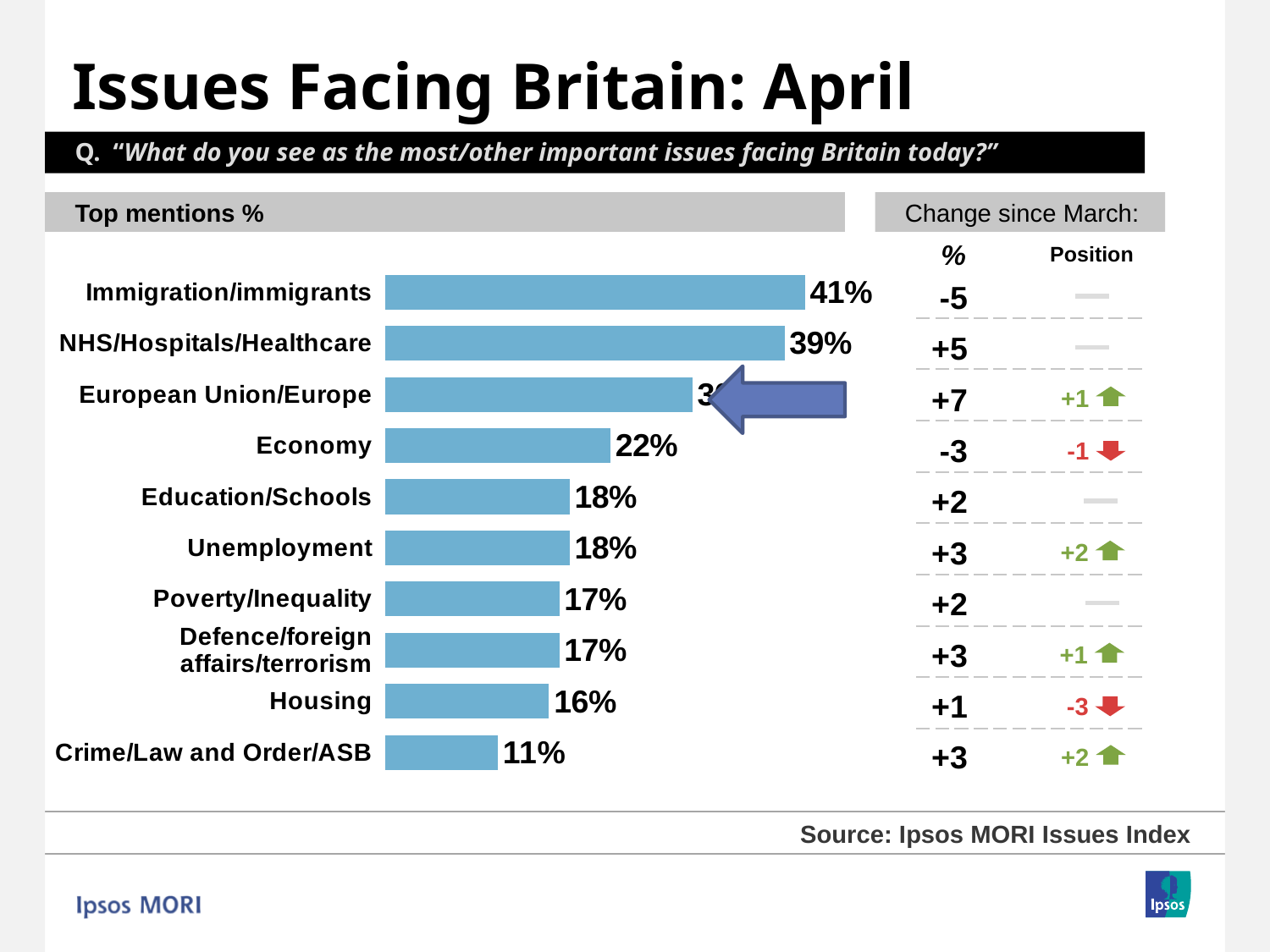
What is the value for NHS/Hospitals/Healthcare? 39% Which is larger, the value for Education/Schools or the value for Housing? Education/Schools What is the value for Crime/Law and Order/ASB? 11% What is the difference between the values for Economy and Housing? 6% Which issue has the highest percentage of mentions? Immigration/immigrants What is the difference between the values for Immigration/immigrants and NHS/Hospitals/Healthcare? 2% Which issue has the lowest percentage of mentions? Crime/Law and Order/ASB What is the value for Immigration/immigrants? 41% What is the value for Housing? 16% What is the value for Economy? 22% What kind of chart is shown on the slide? Bar chart How many issues are shown in the chart? 10